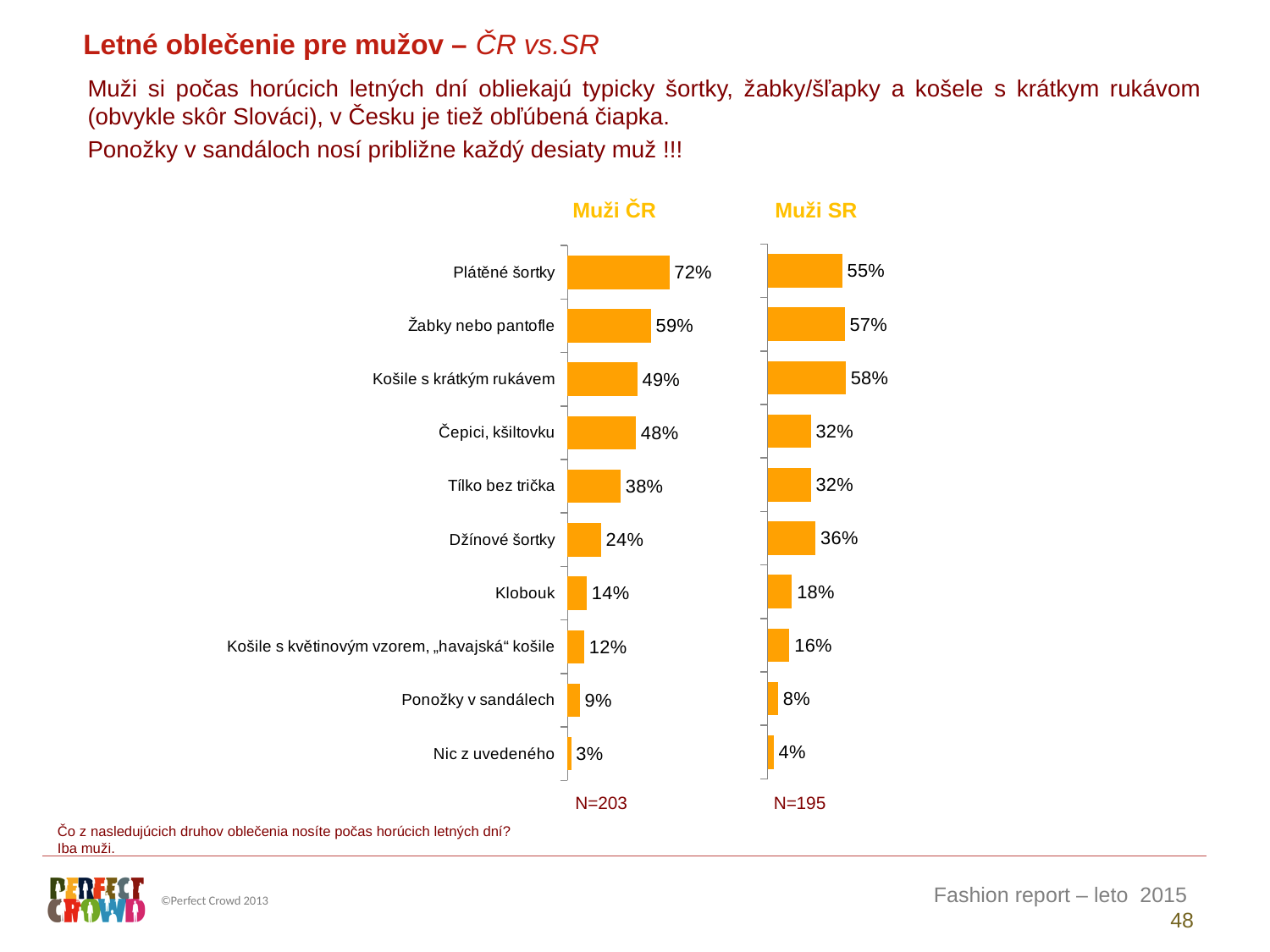
In the Muži SR chart, which is larger: Klobouk or Ponožky v sandálech? Klobouk Which is larger: the Muži ČR value for Džínové šortky or the Muži SR value for Džínové šortky? Muži SR In the Muži ČR chart, what is the difference between Čepici, kšiltovku and Klobouk? 34% In the Muži ČR chart, which category has the lowest value? Nic z uvedeného What sample size (N) is shown under the Muži SR chart? N=195 In the Muži SR chart, which category has the highest value? Košile s krátkým rukávem What is the difference between the Muži ČR and Muži SR values for Plátěné šortky? 17% In the Muži SR chart, what is the value for Košile s krátkým rukávem? 58% In the Muži ČR chart, what is the value for Ponožky v sandálech? 9% In the Muži ČR chart, what is the value for Plátěné šortky? 72% How many categories are shown in the Muži ČR chart? 10 What kind of chart is the Muži SR chart? bar chart